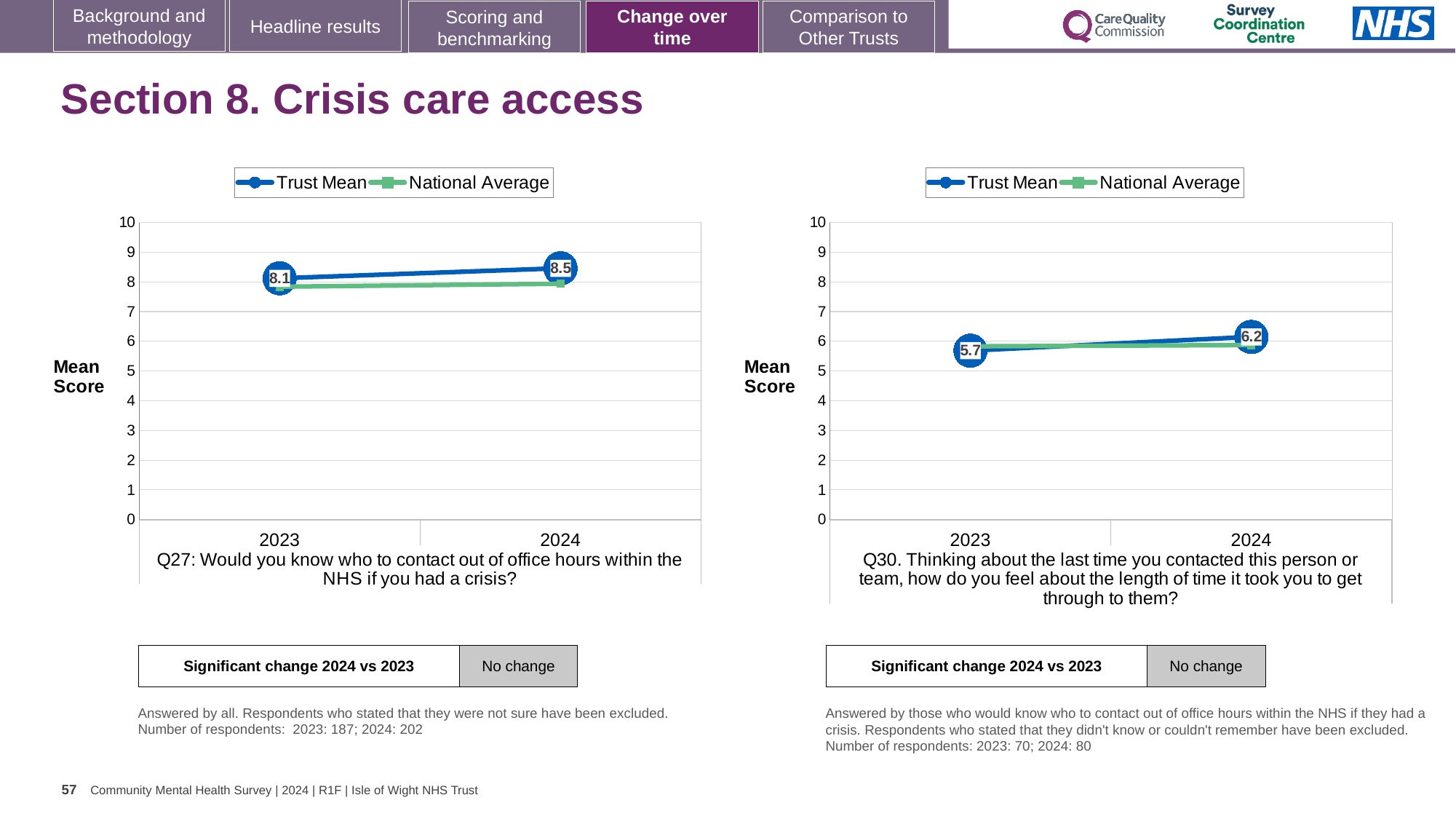
In the right chart (Q30), what is the Trust Mean score for 2024? 6.2 In the left chart (Q27), what is the Trust Mean score for 2024? 8.5 In the right chart (Q30), by how much did the Trust Mean change from 2023 to 2024? 0.5 What kind of chart is the right chart (Q30)? line chart In the left chart (Q27), by how much did the Trust Mean change from 2023 to 2024? 0.4 In the left chart (Q27), what is the Trust Mean score for 2023? 8.1 How many years are plotted on the x axis of the right chart (Q30)? 2 In the right chart (Q30), does the Trust Mean rise or fall from 2023 to 2024? rise In the left chart (Q27), is the National Average value for 2024 greater or less than 7? greater In the right chart (Q30), what is the Trust Mean score for 2023? 5.7 In the left chart (Q27), which year has the higher Trust Mean, 2023 or 2024? 2024 How many series does the legend of the left chart (Q27) list? 2